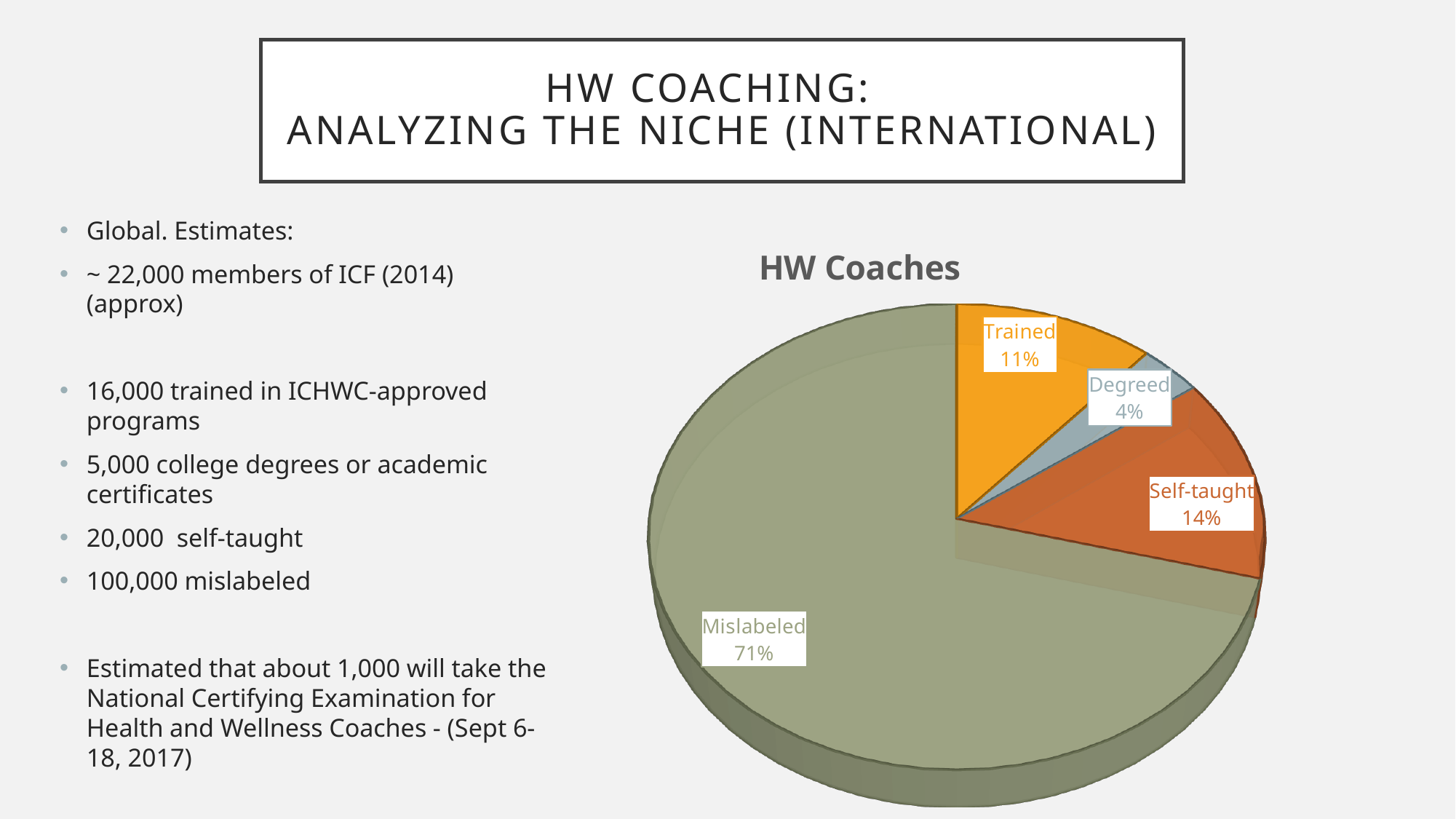
What percentage of HW Coaches are Mislabeled? 71% What colour is the Mislabeled slice? Green Which category has the largest share of the pie? Mislabeled What percentage of HW Coaches are Self-taught? 14% What type of chart is shown on the slide? Pie chart How many categories are shown in the pie chart? 4 Which category has the smallest share of the pie? Degreed What is the title of the chart? HW Coaches What percentage of HW Coaches are Degreed? 4% Which is larger, the Self-taught share or the Trained share? Self-taught What is the difference in percentage points between the Self-taught and Degreed shares? 10 What percentage of HW Coaches are Trained? 11%